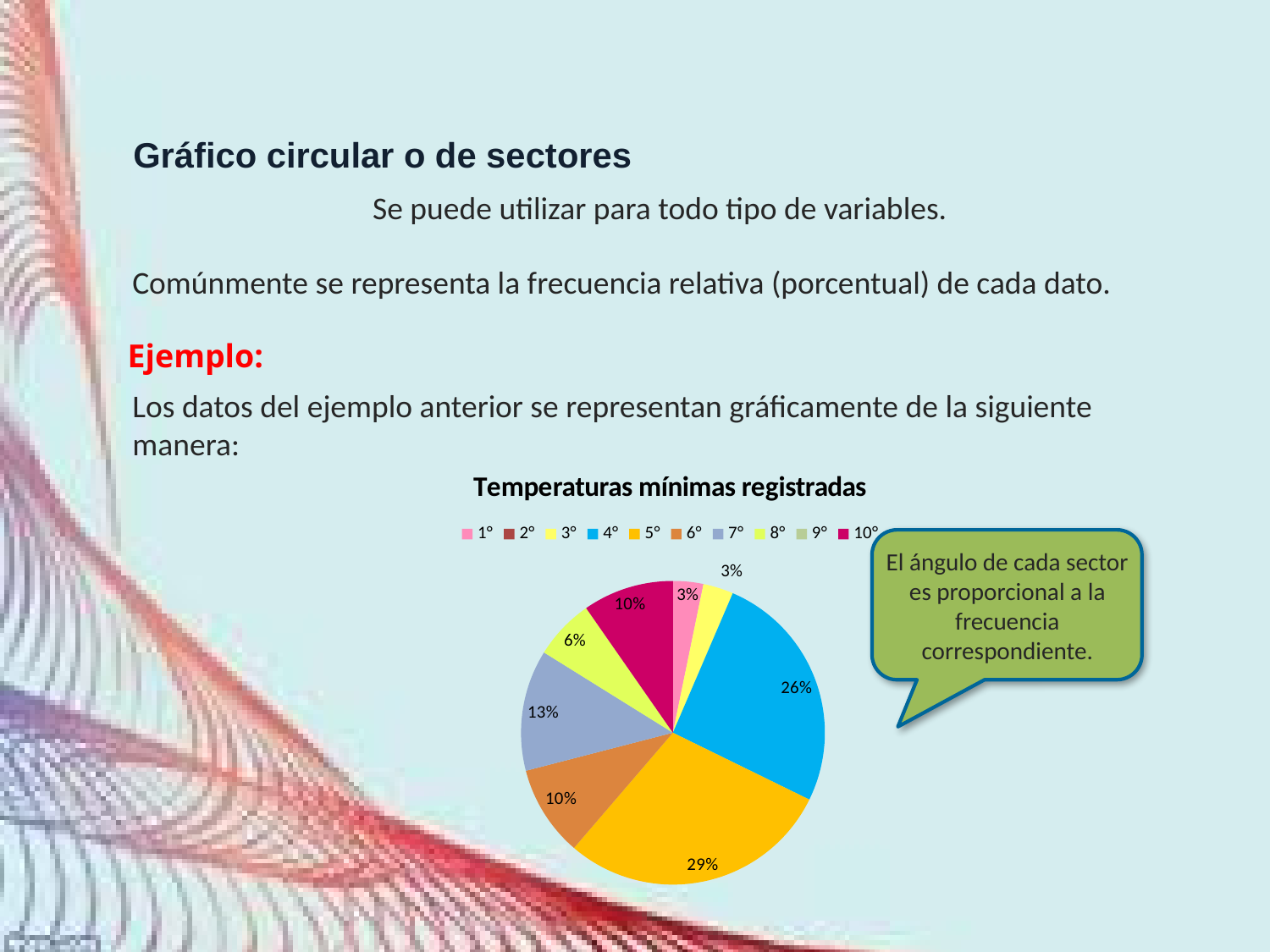
What is the difference in percentage points between the slices for 5° and 4°? 3 What is the title of the chart? Temperaturas mínimas registradas What percentage of the pie corresponds to 10°? 10% What percentage of the pie corresponds to 7°? 13% How many entries does the chart's legend list? 10 Which temperature has the largest slice of the pie? 5° What percentage of the pie corresponds to 8°? 6% What share of the pie does the 4° slice represent? 26% What kind of chart is shown on the slide? pie chart Which slice is larger, 7° or 6°? 7° What percentage of the pie corresponds to 4°? 26% What percentage of the pie corresponds to 5°? 29%